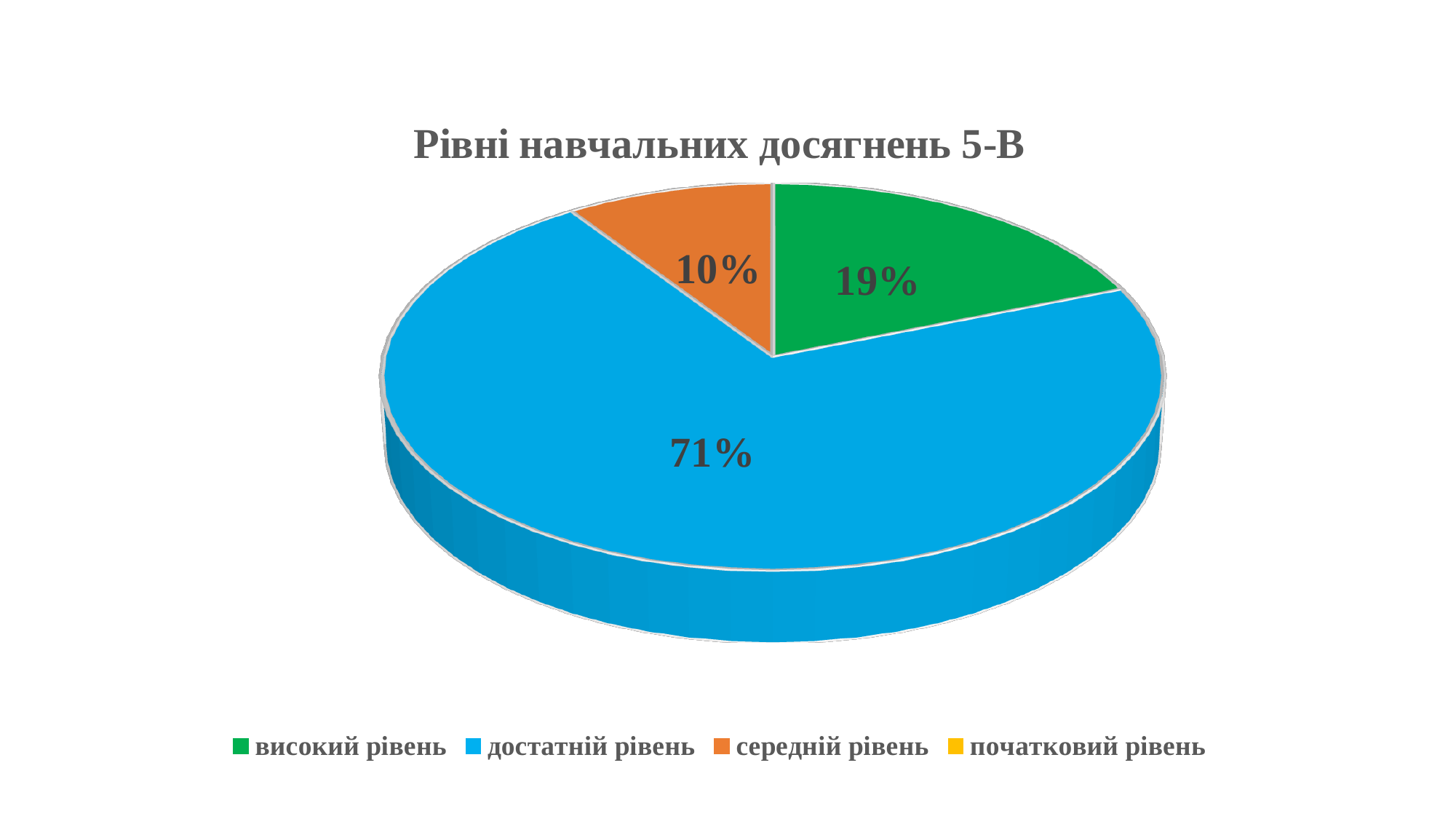
What is the title of the chart? Рівні навчальних досягнень 5-В What is the difference between the shares of високий рівень and середній рівень? 9% Which is larger, the share of високий рівень or the share of середній рівень? високий рівень Which of the visible slices is the smallest? середній рівень How many entries does the legend list? 4 What percentage is shown for достатній рівень? 71% Which level has the largest share of the pie? достатній рівень What percentage is shown for середній рівень? 10% What is the difference between the shares of достатній рівень and високий рівень? 52% What colour is the slice for достатній рівень? blue What kind of chart is shown on the slide? pie chart What percentage is shown for високий рівень? 19%